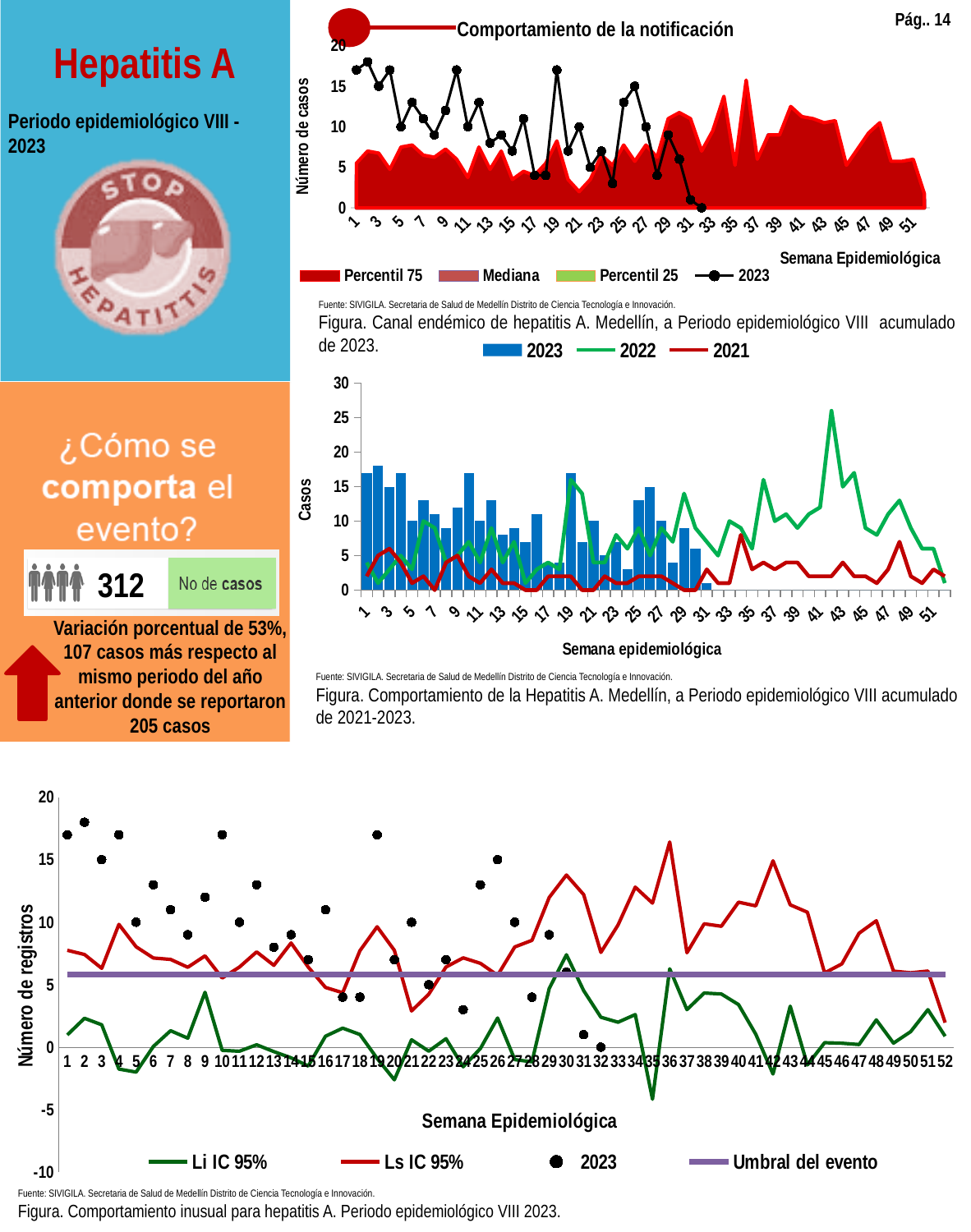
In the bottom chart (Comportamiento inusual para hepatitis A), is the Ls IC 95% value for week 36 greater or less than 15? greater In the top chart titled 'Comportamiento de la notificación', at which week does the 2023 line reach its lowest value? 32 In the middle chart (Comportamiento de la Hepatitis A, 2021-2023), how many series does the legend list? 3 In the middle chart (Comportamiento de la Hepatitis A, 2021-2023), is the 2023 bar for week 2 greater or less than 15? greater In the bottom chart (Comportamiento inusual para hepatitis A), how many entries does the legend list? 4 In the top chart titled 'Comportamiento de la notificación', is the 2023 value for week 1 greater or less than 15? greater In the top chart titled 'Comportamiento de la notificación', how many entries does the legend list? 4 In the middle chart (Comportamiento de la Hepatitis A, 2021-2023), at which week does the 2022 line reach its highest value? 42 In the middle chart (Comportamiento de la Hepatitis A, 2021-2023), which year is plotted as bars? 2023 In the top chart titled 'Comportamiento de la notificación', what is the label of the y axis? Número de casos